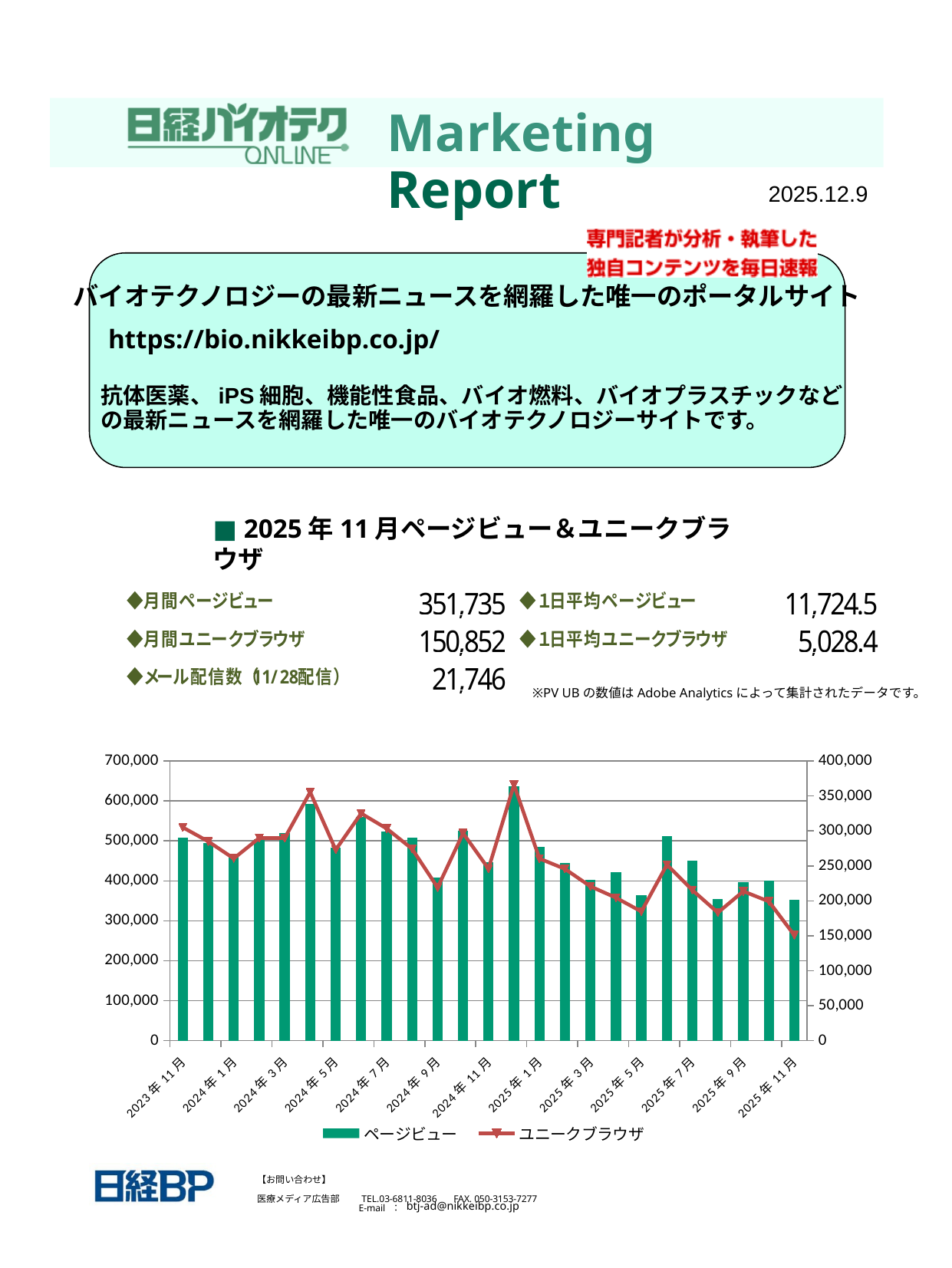
What kind of chart is shown on the slide? A combination bar and line chart According to the slide, what was the monthly page view count (月間ページビュー) for November 2025? 351,735 Which series is drawn as bars in the chart? ページビュー Is the page view bar for 2024年5月 greater or less than 500,000? less What are the two series named in the chart legend? ページビュー and ユニークブラウザ According to the slide, what was the monthly unique browser count (月間ユニークブラウザ) for November 2025? 150,852 How many month labels are shown on the chart's x axis? 13 Is the page view bar for 2025年11月 greater or less than 400,000? less Which month has the lowest unique browser (ユニークブラウザ) value in the chart? 2025年11月 How many series does the chart legend list? 2 Which has the higher page view bar, 2024年5月 or 2025年5月? 2024年5月 Is the unique browser value for 2025年11月 greater or less than 200,000 on the right axis? less